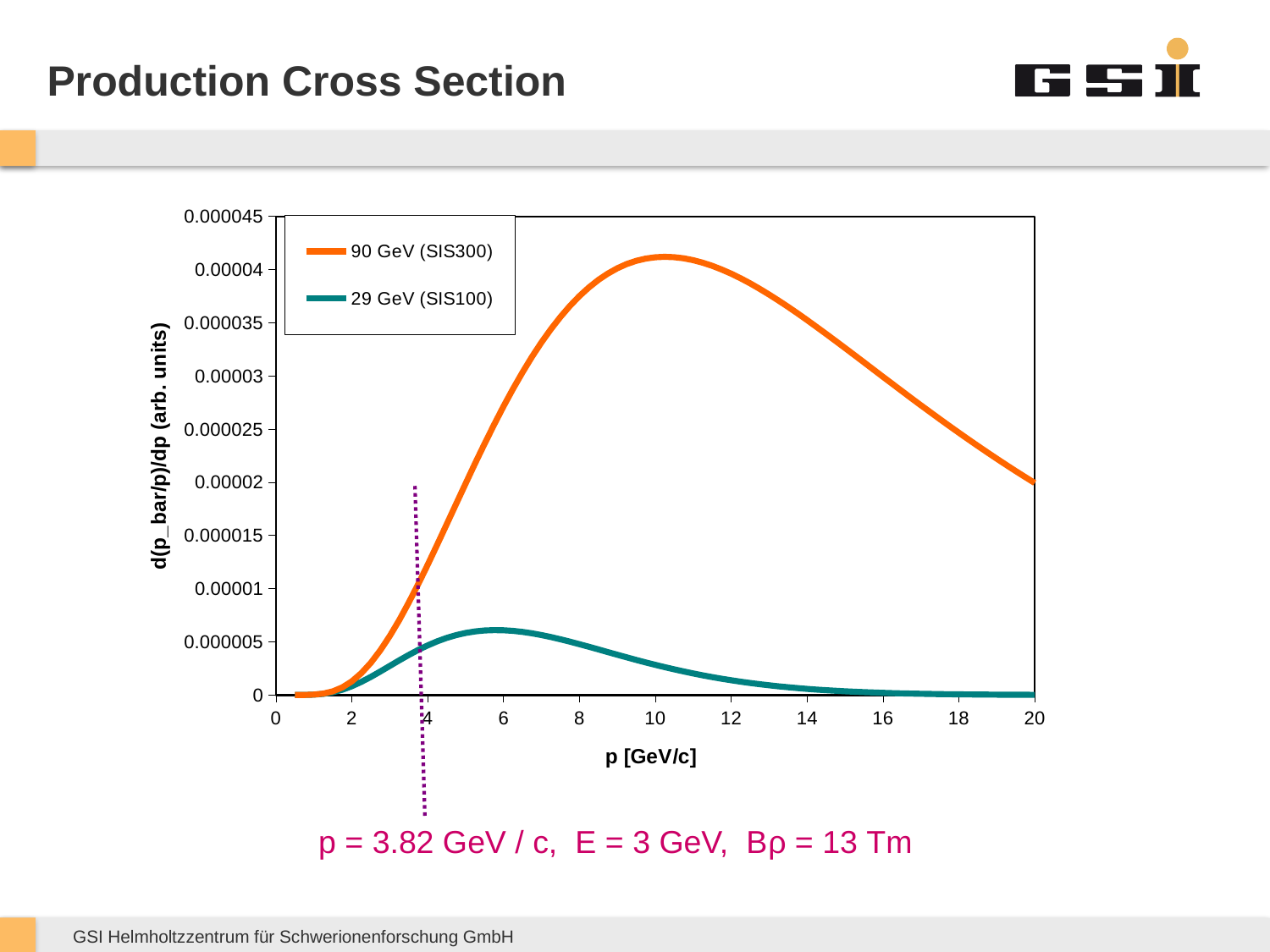
Does the 90 GeV (SIS300) curve rise or fall between p = 12 and p = 20 GeV/c? fall Which series reaches the higher peak value, 90 GeV (SIS300) or 29 GeV (SIS100)? 90 GeV (SIS300) What kind of chart is shown on the slide? Line chart Does the 29 GeV (SIS100) curve rise or fall between p = 8 and p = 16 GeV/c? fall What is the label of the x axis? p [GeV/c] At what momentum is the dotted vertical line drawn, according to the annotation below the chart? 3.82 GeV / c Is the value of the 90 GeV (SIS300) curve at p = 6 GeV/c greater or less than 0.00002? greater What are the two series named in the legend? 90 GeV (SIS300) and 29 GeV (SIS100) How many series does the legend list? 2 Is the peak value of the 90 GeV (SIS300) curve greater or less than 0.000035? greater Is the value of the 90 GeV (SIS300) curve at p = 20 GeV/c greater or less than 0.000025? less